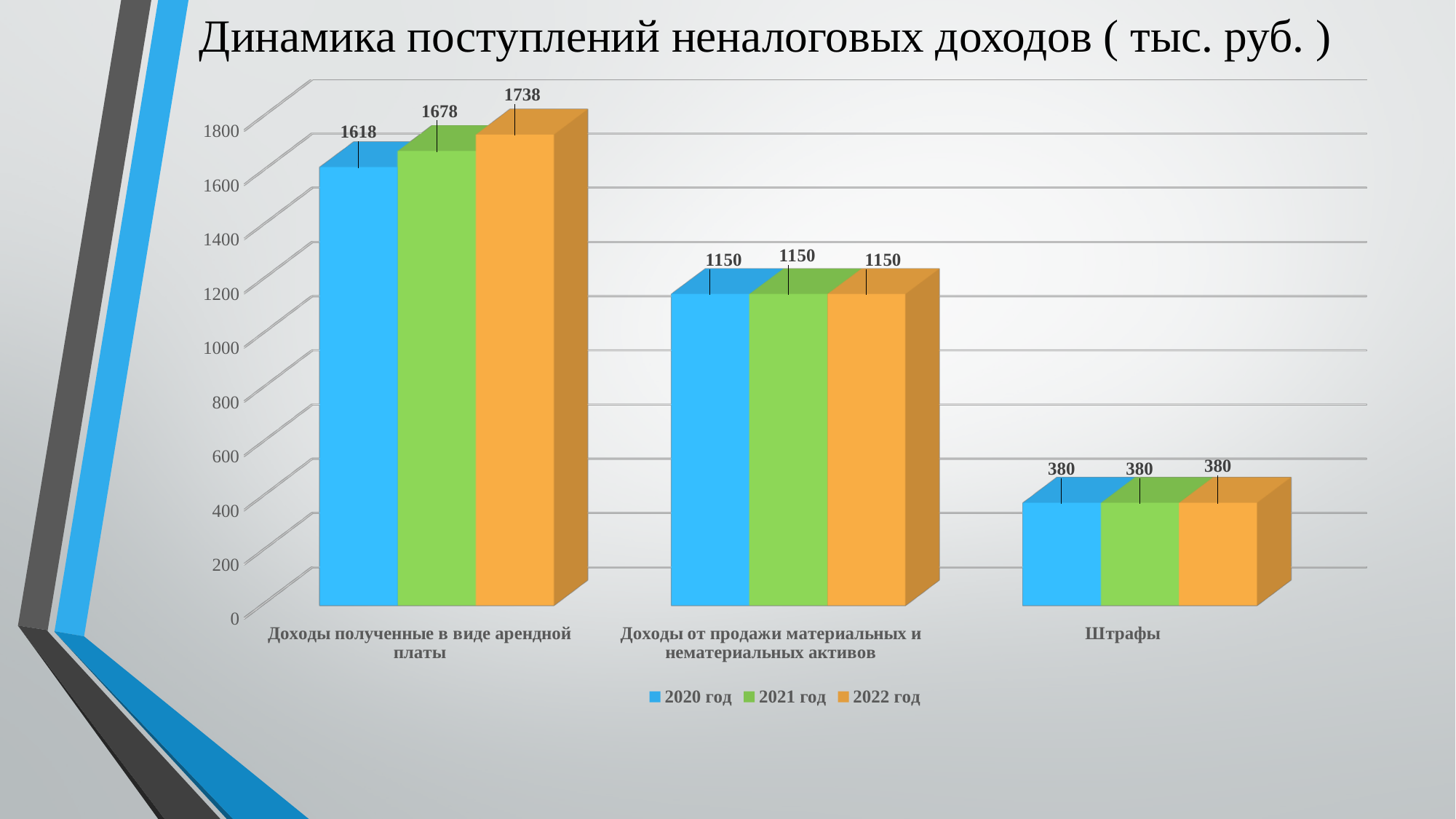
What is the value for 'Доходы от продажи материальных и нематериальных активов' in 2021 год? 1150 Which category has the lowest value in 2022 год? Штрафы Which is larger for 'Доходы полученные в виде арендной платы': the 2020 год value or the 2021 год value? 2021 год What kind of chart is shown on the slide? Bar chart What is the difference between the 2022 год and 2020 год values for 'Доходы полученные в виде арендной платы'? 120 What is the value for 'Доходы полученные в виде арендной платы' in 2022 год? 1738 What is the title of the chart? Динамика поступлений неналоговых доходов ( тыс. руб. ) How many categories are shown on the x axis? 3 How many series does the legend list? 3 Which category has the highest value in 2021 год? Доходы полученные в виде арендной платы What is the value for 'Штрафы' in 2020 год? 380 Do the values for 'Доходы полученные в виде арендной платы' rise or fall from 2020 год to 2022 год? Rise